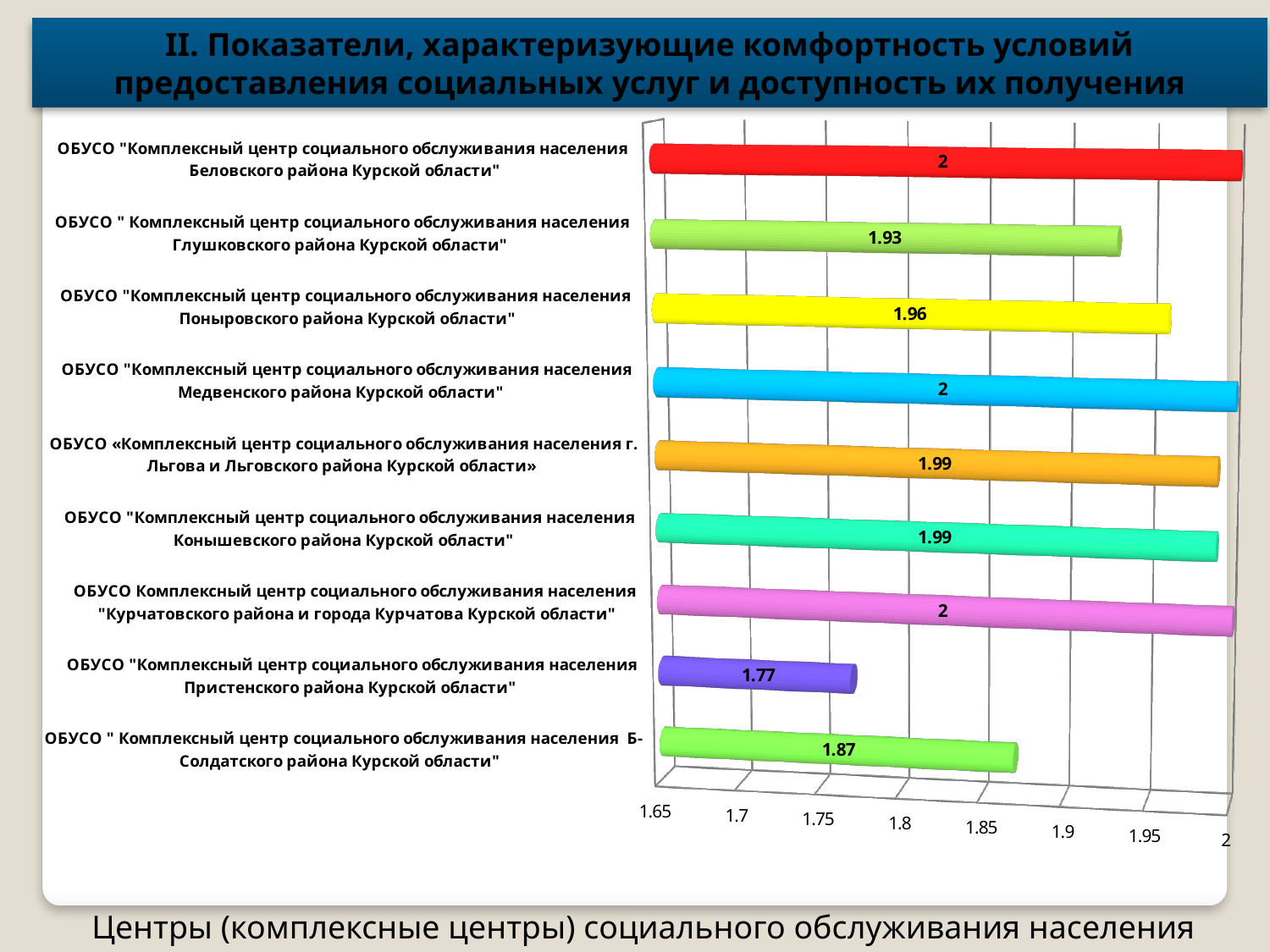
What kind of chart is shown on the slide? bar chart What is the value for ОБУСО «Комплексный центр социального обслуживания населения г. Льгова и Льговского района Курской области»? 1.99 What is the value for ОБУСО "Комплексный центр социального обслуживания населения Пристенского района Курской области"? 1.77 What is the value for ОБУСО "Комплексный центр социального обслуживания населения Б-Солдатского района Курской области"? 1.87 Which centre has the lowest value in the chart? ОБУСО "Комплексный центр социального обслуживания населения Пристенского района Курской области" How many centres (categories) are plotted in the chart? 9 Is the value for the Б-Солдатского района centre greater or less than 1.9? less Which is larger: the value for the Глушковского района centre or the value for the Поныровского района centre? Поныровского района centre (1.96) What is the value for ОБУСО "Комплексный центр социального обслуживания населения Глушковского района Курской области"? 1.93 What is the difference between the value for the Конышевского района centre and the value for the Б-Солдатского района centre? 0.12 What is the value for ОБУСО "Комплексный центр социального обслуживания населения Поныровского района Курской области"? 1.96 What is the difference between the value for the Беловского района centre and the value for the Пристенского района centre? 0.23